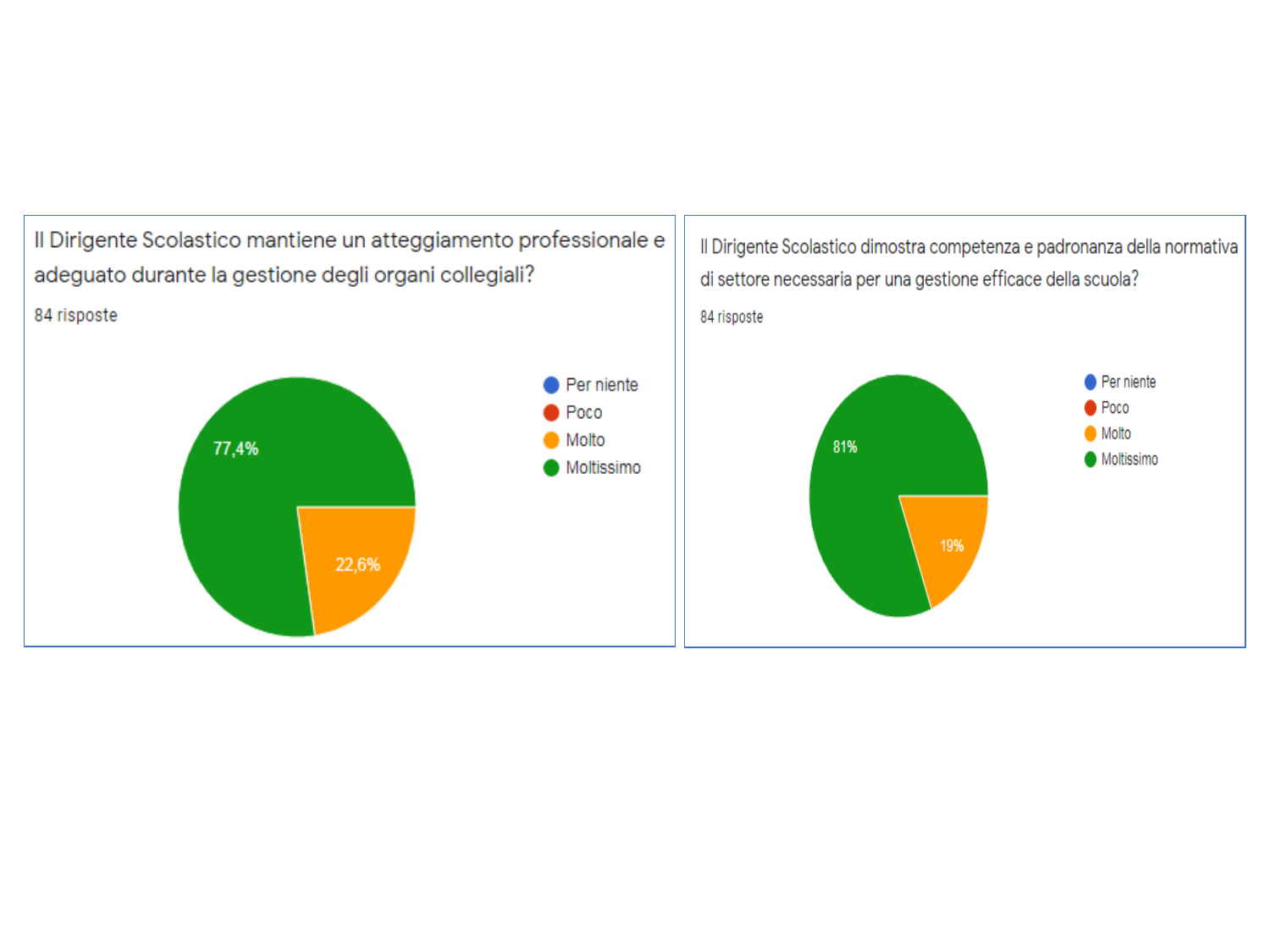
How many entries does the legend of the left chart list? 4 How many responses ('risposte') does the left chart report? 84 What type of chart is shown on the right? pie chart In the right chart (about competence in sector regulations), what share of responses is 'Molto'? 19% In the right chart (about competence in sector regulations), what share of responses is 'Moltissimo'? 81% In the right chart, what is the difference between the 'Moltissimo' and 'Molto' shares? 62% In the left chart, which category has the largest share? Moltissimo In the left chart, what is the difference between the 'Moltissimo' and 'Molto' shares? 54,8% Which chart has the larger 'Moltissimo' share, the left one or the right one? the right one In the right chart, which category has the largest share? Moltissimo In the left chart (about professional attitude during collegial bodies), what share of responses is 'Moltissimo'? 77,4% In the left chart (about professional attitude during collegial bodies), what share of responses is 'Molto'? 22,6%